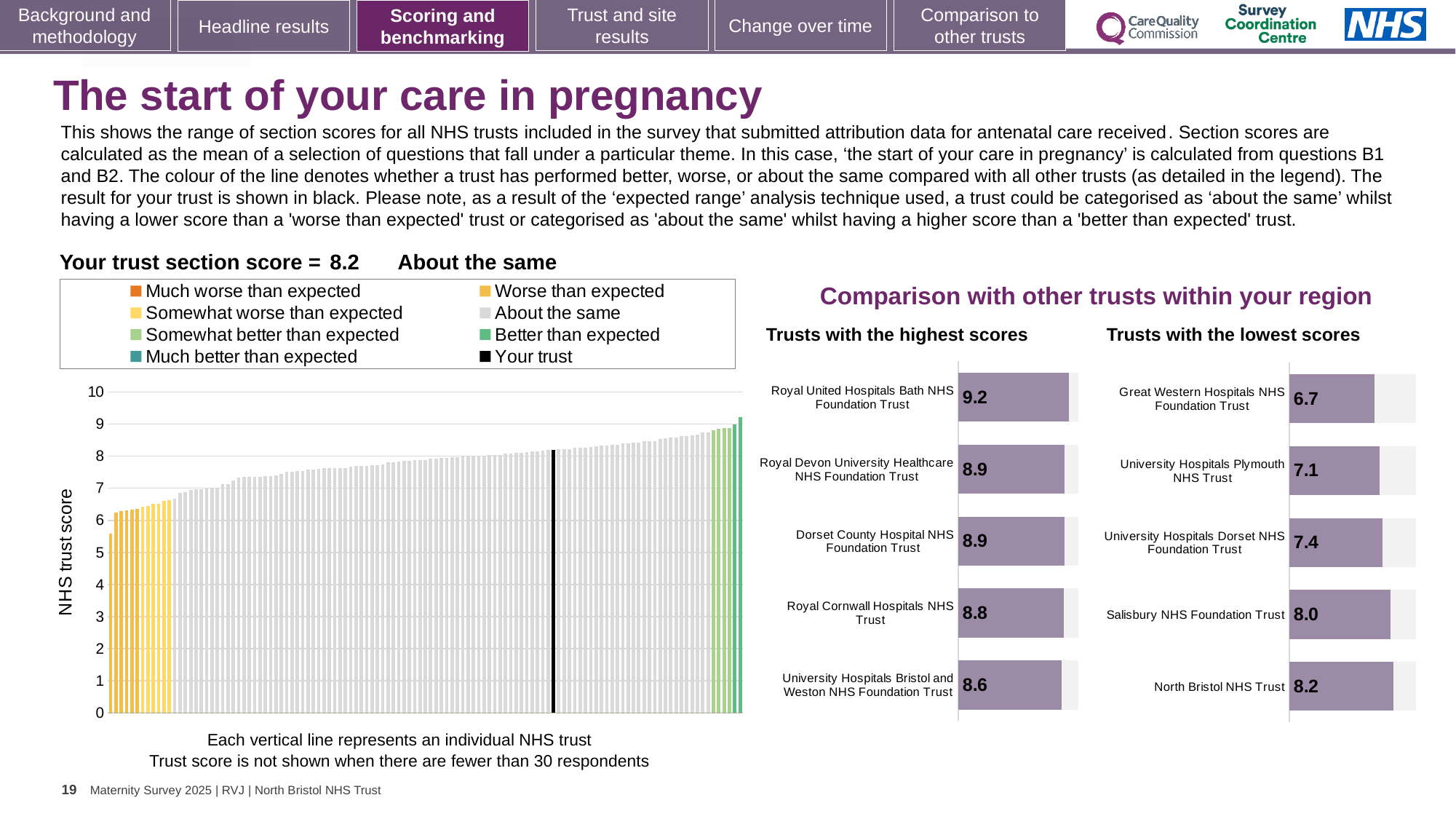
How many entries does the legend above the 'NHS trust score' chart list? 8 In the 'NHS trust score' chart on the left, is the value of the lowest bar greater or less than 7? less In the 'Trusts with the lowest scores' chart, what is the difference between the scores of Salisbury NHS Foundation Trust and University Hospitals Plymouth NHS Trust? 0.9 In the 'Trusts with the highest scores' chart, what is the score for Royal United Hospitals Bath NHS Foundation Trust? 9.2 In the 'Trusts with the highest scores' chart, which has the larger score: Royal Cornwall Hospitals NHS Trust or Royal Devon University Healthcare NHS Foundation Trust? Royal Devon University Healthcare NHS Foundation Trust In the 'Trusts with the highest scores' chart, what is the score for University Hospitals Bristol and Weston NHS Foundation Trust? 8.6 In the 'Trusts with the lowest scores' chart, what is the score for Great Western Hospitals NHS Foundation Trust? 6.7 In the 'Trusts with the lowest scores' chart, what is the score for North Bristol NHS Trust? 8.2 In the 'Trusts with the lowest scores' chart, which trust has the lowest score? Great Western Hospitals NHS Foundation Trust How many trusts are shown in the 'Trusts with the lowest scores' chart? 5 In the 'Trusts with the highest scores' chart, which trust has the highest score? Royal United Hospitals Bath NHS Foundation Trust What kind of chart is the 'NHS trust score' chart on the left of the slide? Bar chart